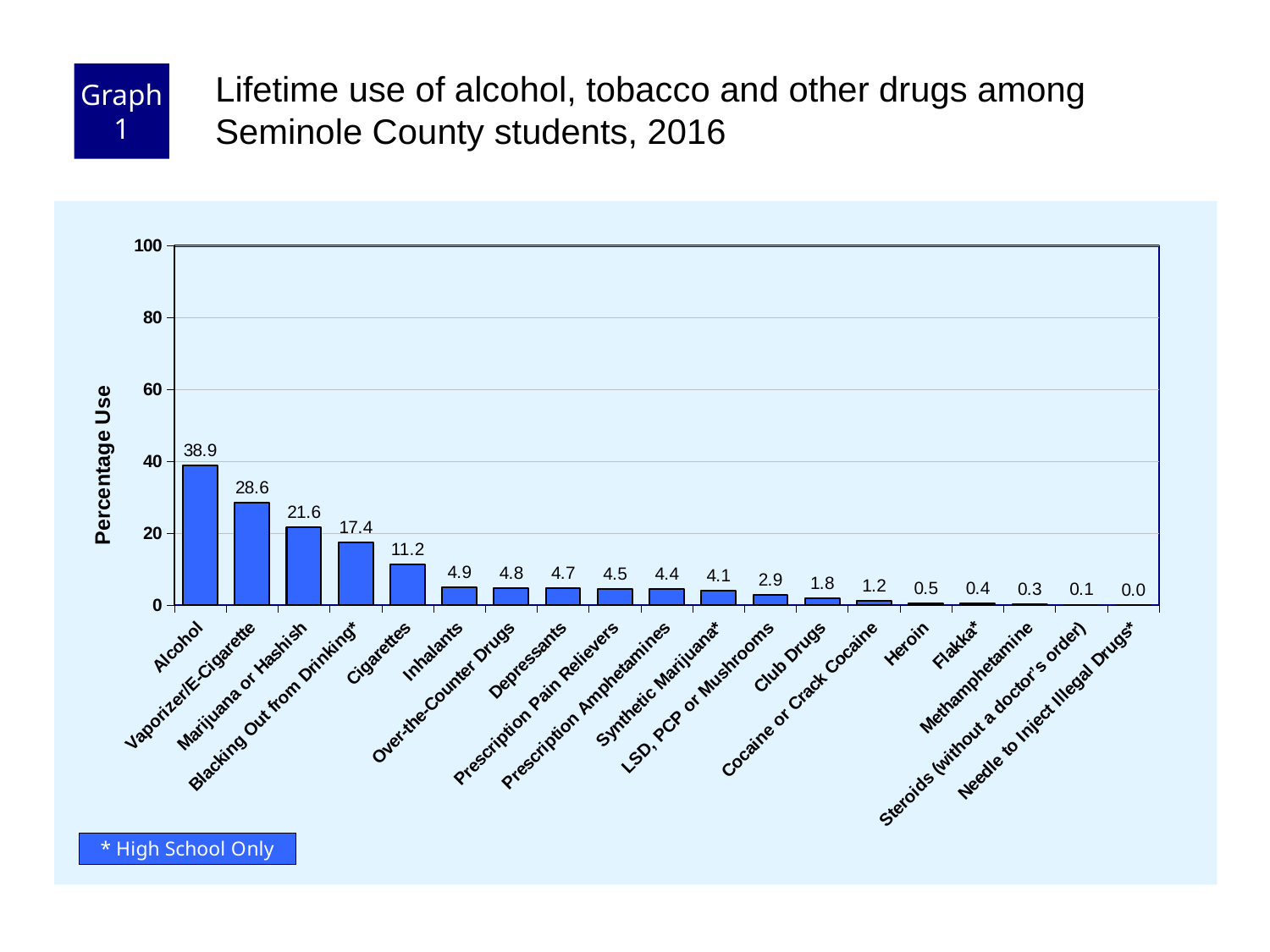
Which has a higher percentage use, Marijuana or Hashish or Cigarettes? Marijuana or Hashish Which category has the highest percentage use? Alcohol How many categories are shown on the x axis? 19 Do the values rise or fall moving from left to right along the x axis? fall What is the percentage use for Heroin? 0.5 Which category has the lowest percentage use? Needle to Inject Illegal Drugs* What kind of chart is shown on the slide? bar chart Is the value for Blacking Out from Drinking* greater or less than 20? less What is the percentage use for Cigarettes? 11.2 What is the percentage use for Alcohol? 38.9 What is the difference in percentage use between Alcohol and Vaporizer/E-Cigarette? 10.3 What is the label on the y axis? Percentage Use